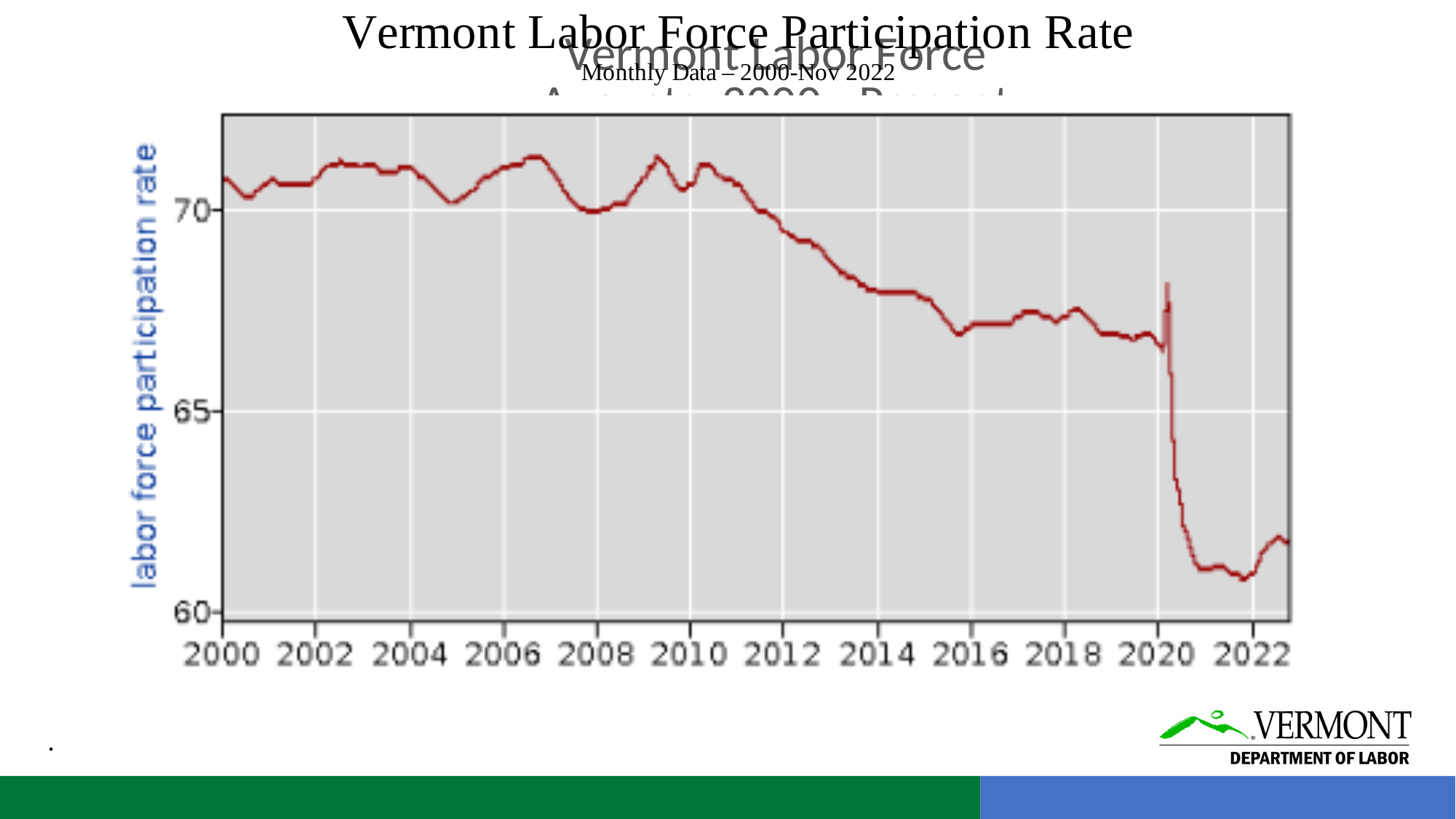
What kind of chart is shown on the slide? line chart What label is shown on the vertical axis of the chart? labor force participation rate Is the labor force participation rate in 2018 greater or less than 70? less Is the labor force participation rate in 2018 greater or less than 65? greater Is the labor force participation rate in 2000 greater or less than 70? greater Does the labor force participation rate rise or fall between 2012 and 2014? fall Overall, does the labor force participation rate rise or fall from 2000 to 2022? fall Which year has a higher labor force participation rate, 2006 or 2021? 2006 Which year has a lower labor force participation rate, 2014 or 2022? 2022 What is the title of the chart on the slide? Vermont Labor Force Participation Rate